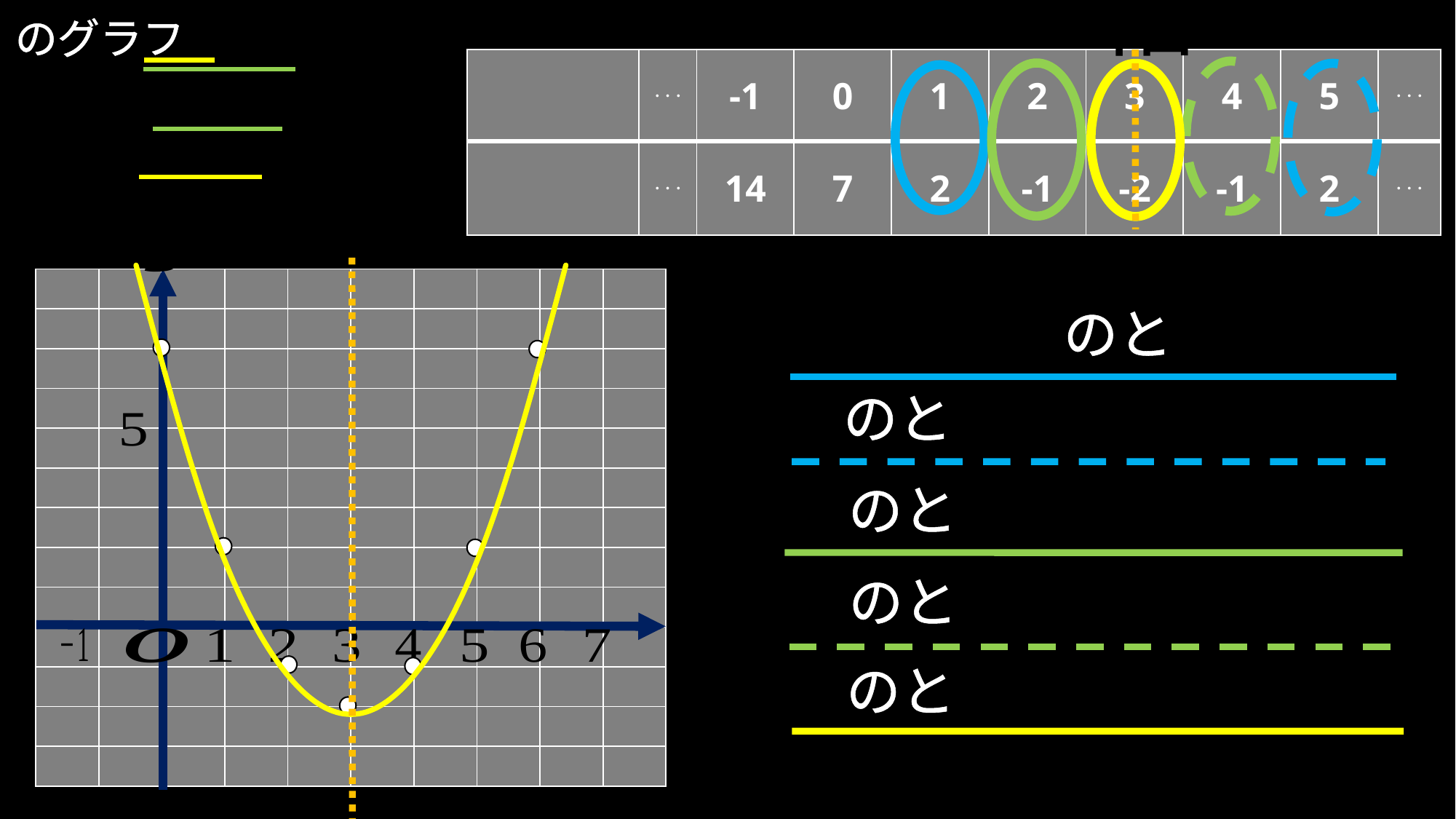
At which x value in the table is the y value highest? -1 At which x value in the table is the y value lowest? 3 What is the difference between the y values at x = -1 and x = 0 in the table? 7 Which is larger, the y value at x = 1 or the y value at x = 2? x = 1 (2) How many points are plotted on the parabola graph? 7 According to the table, what is the y value when x = 0? 7 At which x value is the orange dotted vertical line drawn on the graph? 3 According to the table, what is the y value when x = 3? -2 What kind of graph is plotted on the grid at the lower left of the slide? A parabola (curve) graph According to the table, what is the y value when x = -1? 14 Do the y values in the table rise or fall as x goes from 0 to 3? Fall